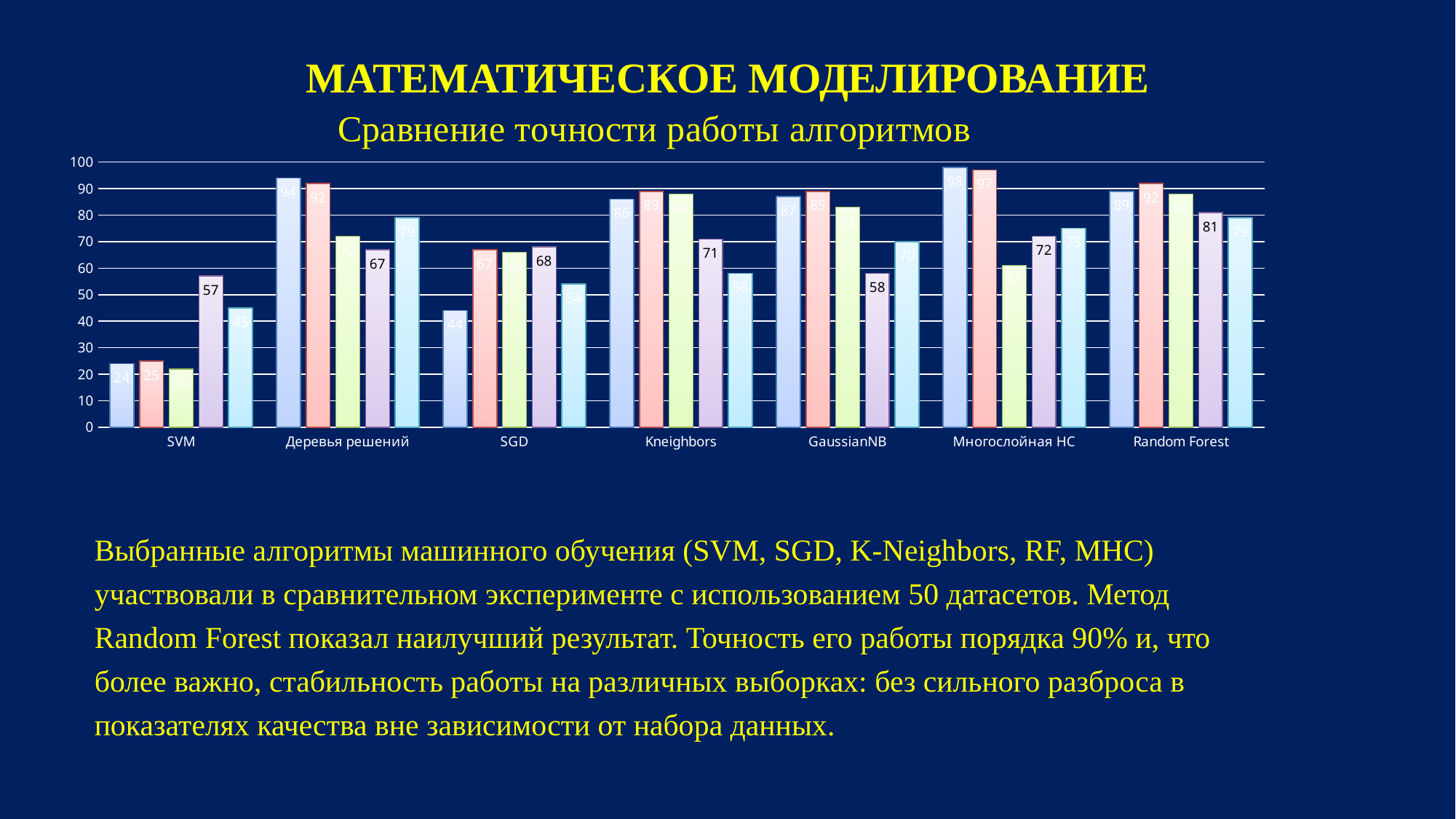
What is the value of the fourth (purple) bar for GaussianNB? 58 Which algorithm has the lowest first (blue) bar in the chart? SVM What is the value of the fourth (purple) bar for Random Forest? 81 What is the value of the fourth (purple) bar for SVM? 57 Which is larger: the fourth (purple) bar for Многослойная НС or the fourth (purple) bar for Random Forest? Random Forest What kind of chart is shown on the slide? bar chart How many algorithm categories are shown on the x axis of the chart? 7 How many bars are plotted for each algorithm category in the chart? 5 Which algorithm has the highest first (blue) bar in the chart? Многослойная НС What is the difference between the fourth (purple) bar for Random Forest and the fourth (purple) bar for SVM? 24 What is the value of the fourth (purple) bar for Kneighbors? 71 What is the title of the chart on the slide? Сравнение точности работы алгоритмов